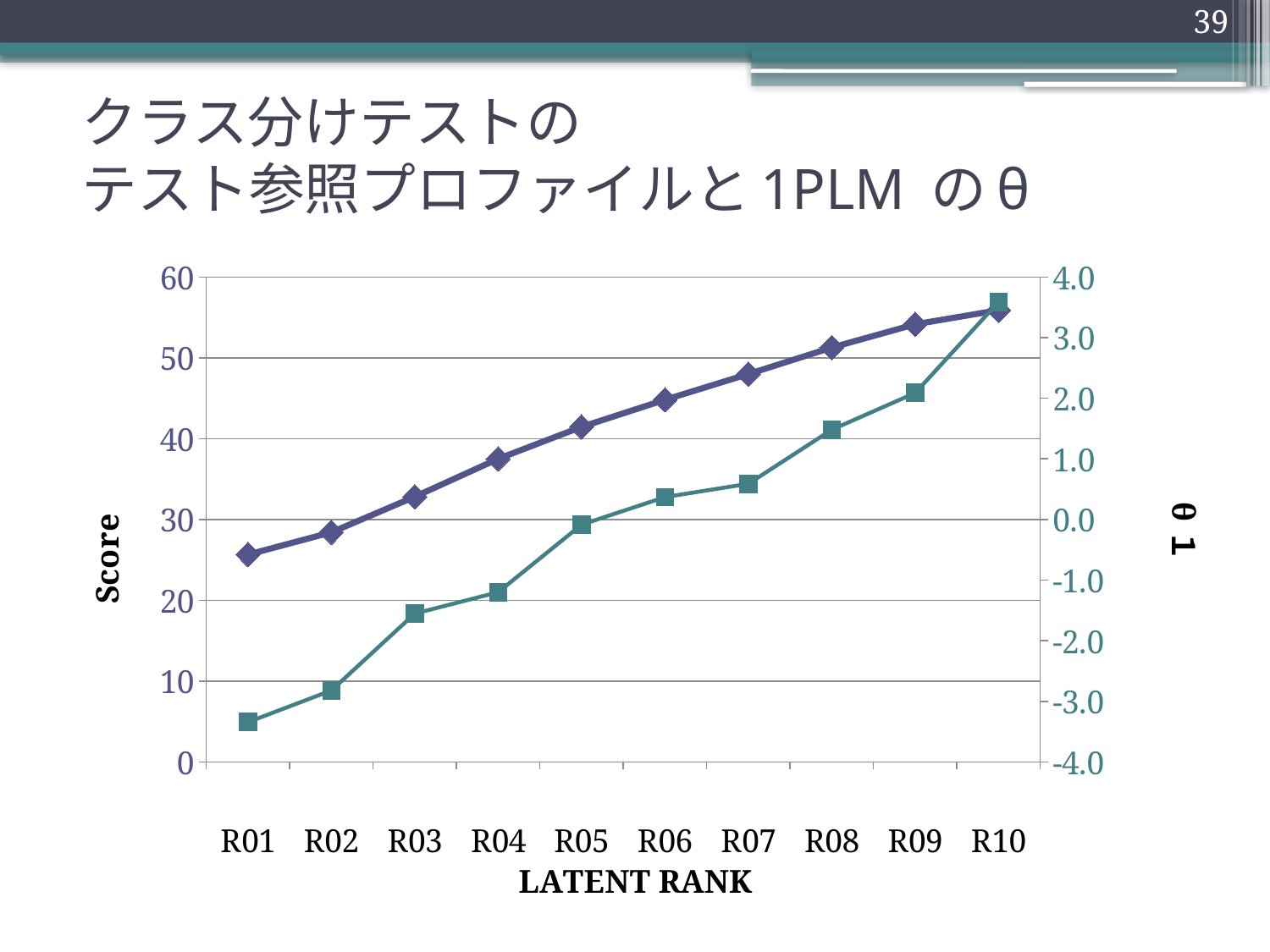
How many lines are plotted on the chart? 2 What kind of chart is shown on the slide? line chart What is the title of the left y axis? Score What is the title of the x axis? LATENT RANK Is the Score value for R10 greater or less than 50? greater Is the θ value for R10 greater or less than 3.0? greater Does the θ line (teal squares) rise or fall from R01 to R10? rise Which latent rank has the highest Score value? R10 Does the Score line (purple diamonds) rise or fall from R01 to R10? rise How many latent rank categories are shown on the x axis? 10 Is the Score value for R01 greater or less than 30? less Which latent rank has the lowest θ value? R01